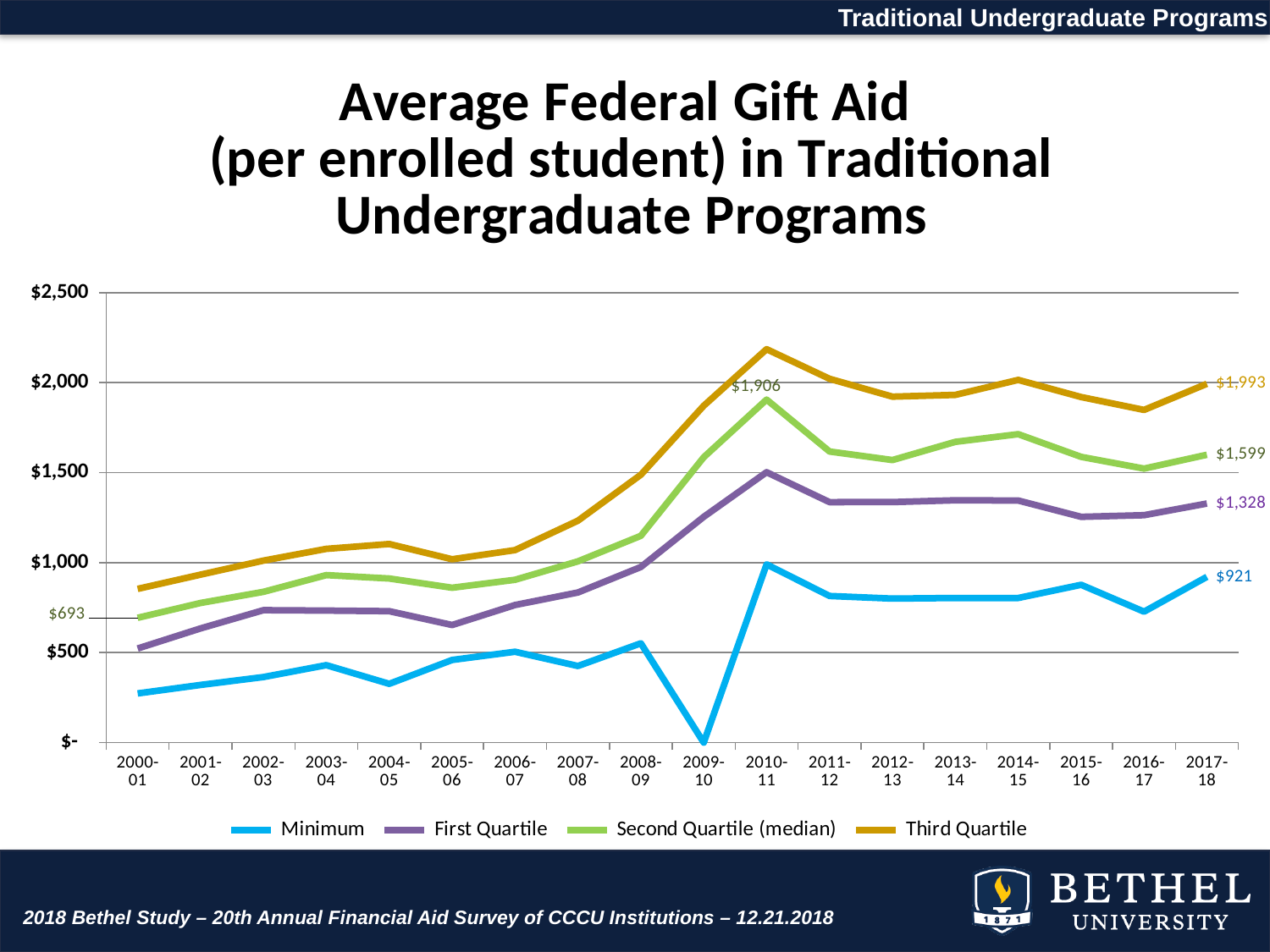
What is the Third Quartile value for 2017-18? $1,993 What is the Second Quartile (median) value for 2000-01? $693 What is the Second Quartile (median) value for 2017-18? $1,599 What is the Minimum value for 2017-18? $921 By how much did the Second Quartile (median) increase from 2000-01 to 2017-18? $906 How many academic years are plotted along the x axis? 18 What is the First Quartile value for 2017-18? $1,328 What kind of chart is shown on the slide? line chart Is the Minimum value for 2009-10 greater or less than $500? less What is the Second Quartile (median) value for 2010-11? $1,906 How many series does the legend list? 4 In which academic year is the Second Quartile (median) highest? 2010-11